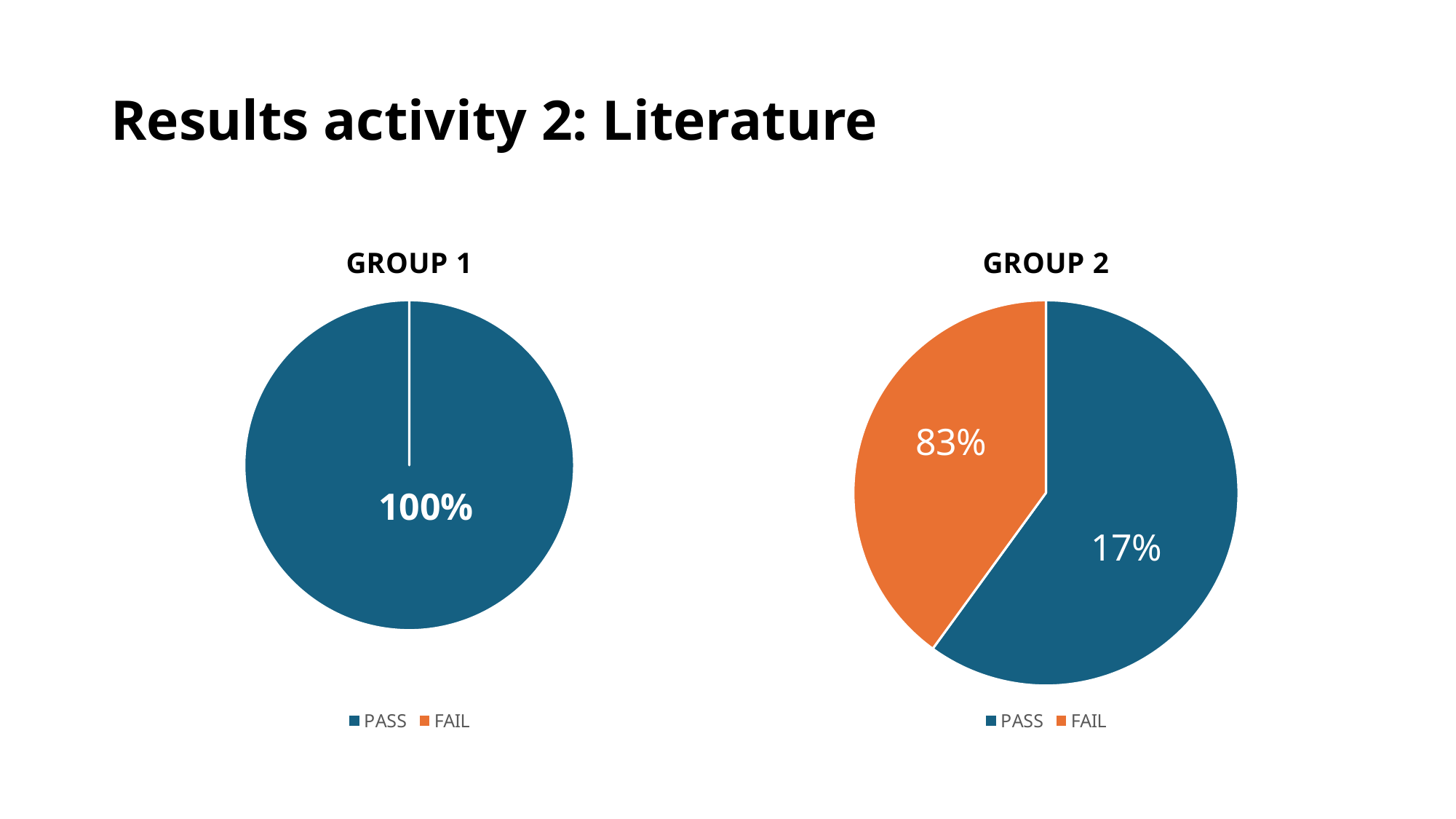
In the GROUP 1 chart, which category makes up the whole pie? PASS What is the title of the chart on the right of the slide? GROUP 2 In the GROUP 2 chart, what percentage label is printed on the blue (PASS) slice? 17% How many series does the legend of the GROUP 2 chart list? 2 How many series does the legend of the GROUP 1 chart list? 2 What kind of chart is shown under the title GROUP 1? Pie chart In the GROUP 2 chart, which colour represents FAIL in the legend? Orange In the GROUP 2 chart, how many slices does the pie have? 2 How many pie charts are on the slide? 2 In the GROUP 1 chart, what percentage is shown for PASS? 100% In the GROUP 2 chart, what percentage label is printed on the orange (FAIL) slice? 83%